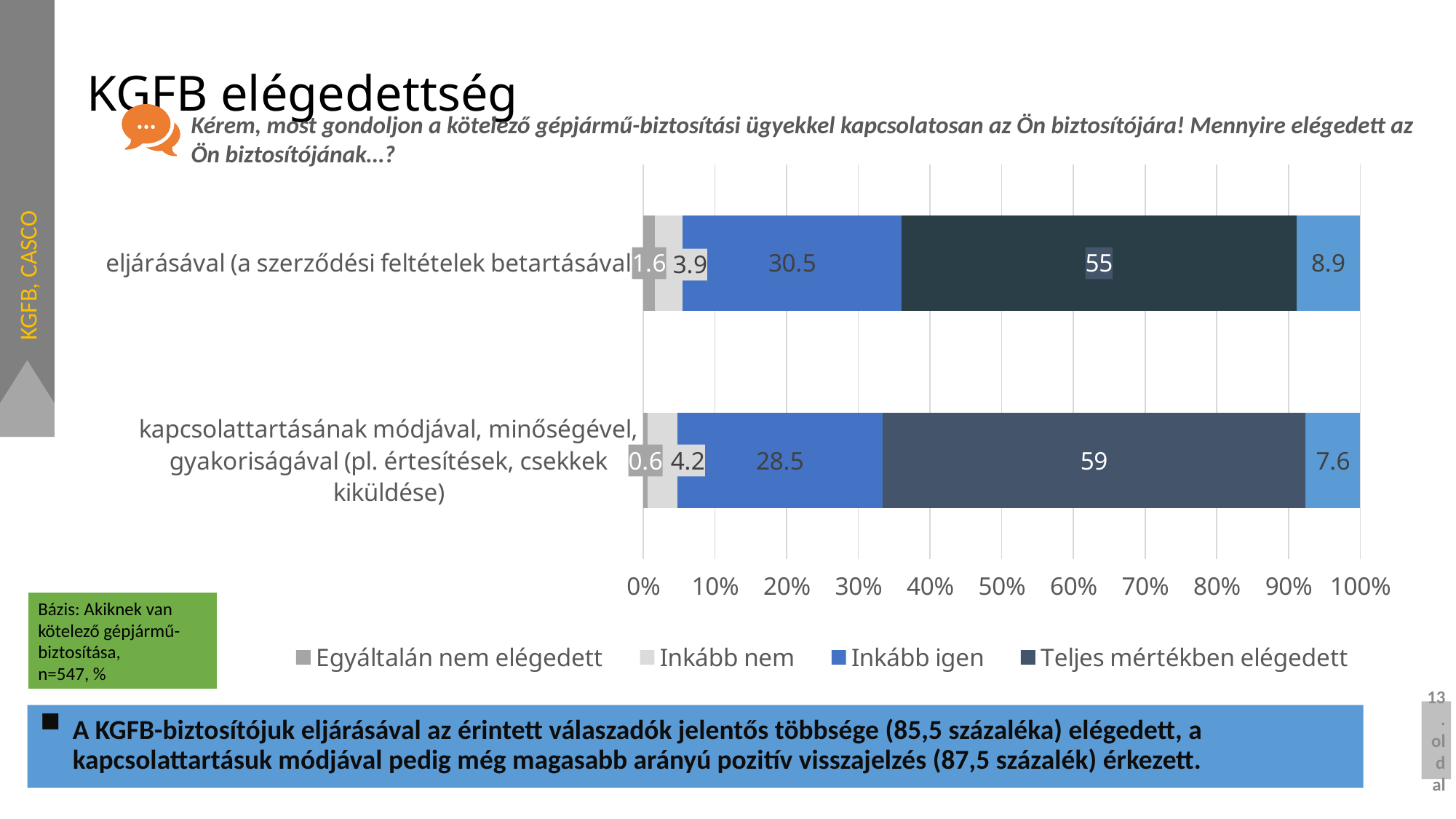
What kind of chart is shown on the slide? Stacked bar chart What is the base (n) stated for the chart? n=547 What is the value of "Inkább igen" for the category "kapcsolattartásának módjával, minőségével, gyakoriságával"? 28.5 What is the value of "Teljes mértékben elégedett" for the category "eljárásával (a szerződési feltételek betartásával)"? 55 Which category has the higher value for "Teljes mértékben elégedett"? kapcsolattartásának módjával, minőségével, gyakoriságával How many categories are shown on the chart? 2 How many series does the legend list? 4 What is the value of "Inkább nem" for the category "eljárásával (a szerződési feltételek betartásával)"? 3.9 What is the combined value of "Inkább igen" and "Teljes mértékben elégedett" for the category "eljárásával (a szerződési feltételek betartásával)"? 85.5 What is the difference between the "Teljes mértékben elégedett" values of the two categories? 4 Which is larger: the "Inkább igen" value for "eljárásával" or for "kapcsolattartásának módjával"? eljárásával What is the value of "Egyáltalán nem elégedett" for the category "kapcsolattartásának módjával, minőségével, gyakoriságával"? 0.6